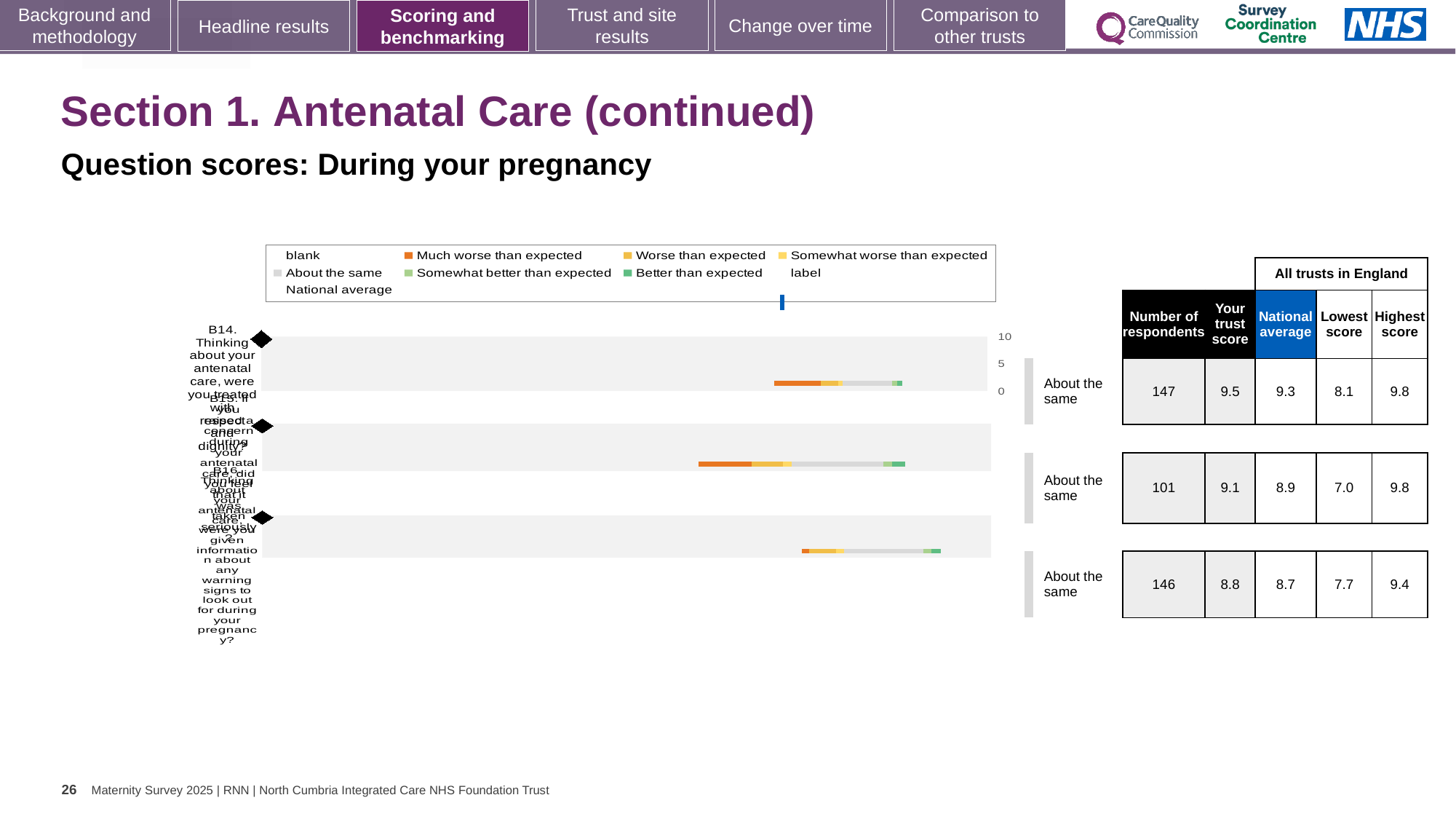
In the table beside the chart, which is larger: the lowest score for the second row (7.0) or the lowest score for the third row (7.7)? the third row (7.7) In the table beside the chart, what is the difference between the trust score and the national average for the first row (B14)? 0.2 What kind of chart is shown on the slide? bar chart How many entries does the chart legend list? 9 What colour does the legend use for 'Better than expected'? green In the table beside the chart, which row has the highest 'Your trust score'? the first row (B14), 9.5 In the table beside the chart, what is the national average for the third row (B16, warning signs during pregnancy)? 8.7 How many question bars are plotted in the chart? 3 In the table beside the chart, what is the 'Your trust score' for the first row (B14, treated with respect and dignity)? 9.5 In the table beside the chart, how many respondents are recorded for the first row (B14)? 147 What benchmark category is shown next to each of the three question bars? About the same What colour does the legend use for 'Much worse than expected'? orange